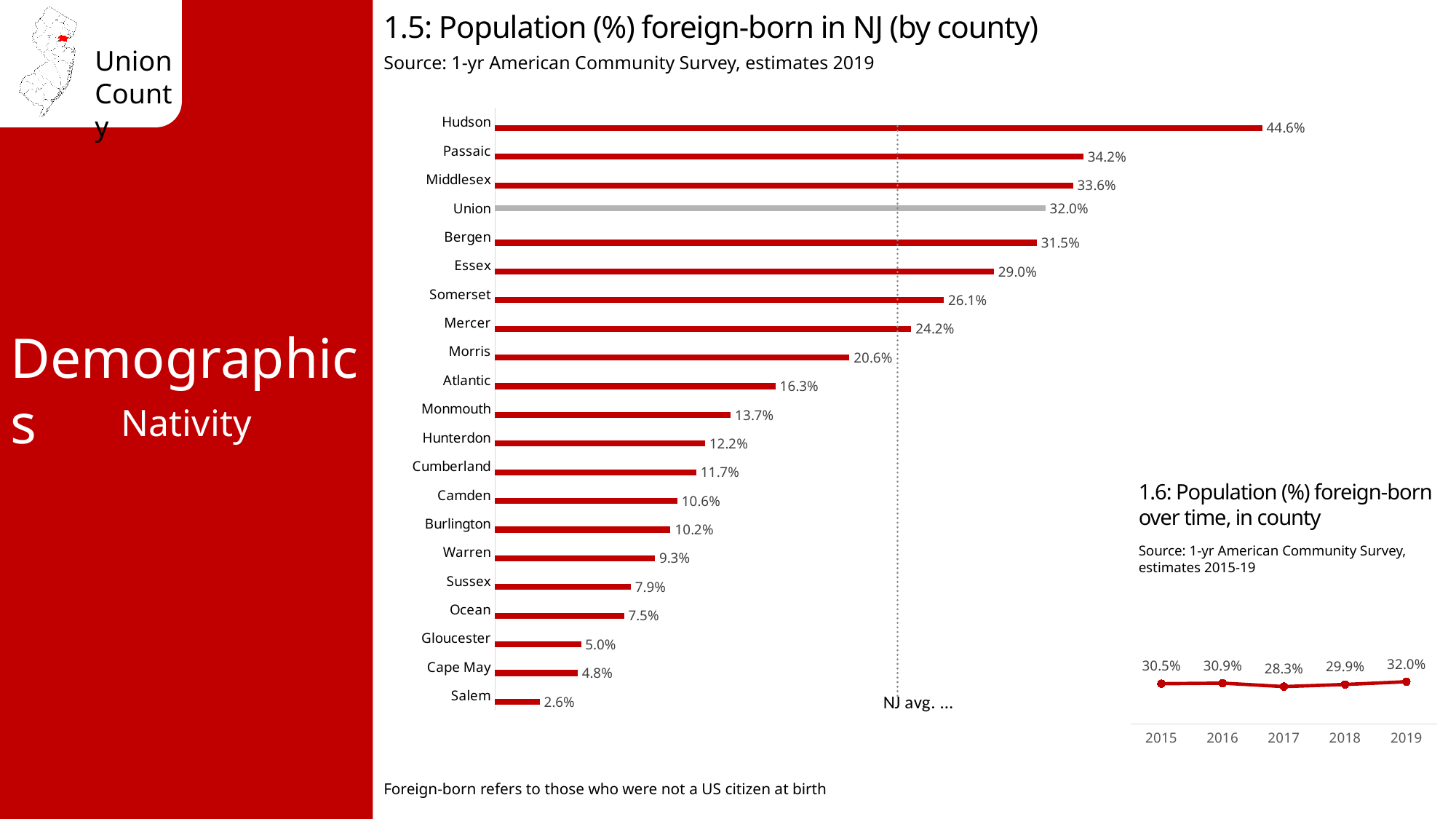
In the chart '1.5: Population (%) foreign-born in NJ (by county)', what is the value for Mercer? 24.2% What kind of chart is '1.5: Population (%) foreign-born in NJ (by county)'? Bar chart What kind of chart is '1.6: Population (%) foreign-born over time, in county'? Line chart In the chart '1.5: Population (%) foreign-born in NJ (by county)', which is larger, Bergen or Essex? Bergen In the chart '1.5: Population (%) foreign-born in NJ (by county)', how many counties are shown? 21 In the chart '1.6: Population (%) foreign-born over time, in county', what is the value for 2017? 28.3% In the chart '1.5: Population (%) foreign-born in NJ (by county)', which county has the highest value? Hudson In the chart '1.5: Population (%) foreign-born in NJ (by county)', what is the difference between Hudson and Passaic? 10.4% In the chart '1.6: Population (%) foreign-born over time, in county', which year has the lowest value? 2017 In the chart '1.5: Population (%) foreign-born in NJ (by county)', what is the value for Union? 32.0% In the chart '1.5: Population (%) foreign-born in NJ (by county)', which county has the lowest value? Salem In the chart '1.6: Population (%) foreign-born over time, in county', what is the difference between 2019 and 2015? 1.5%